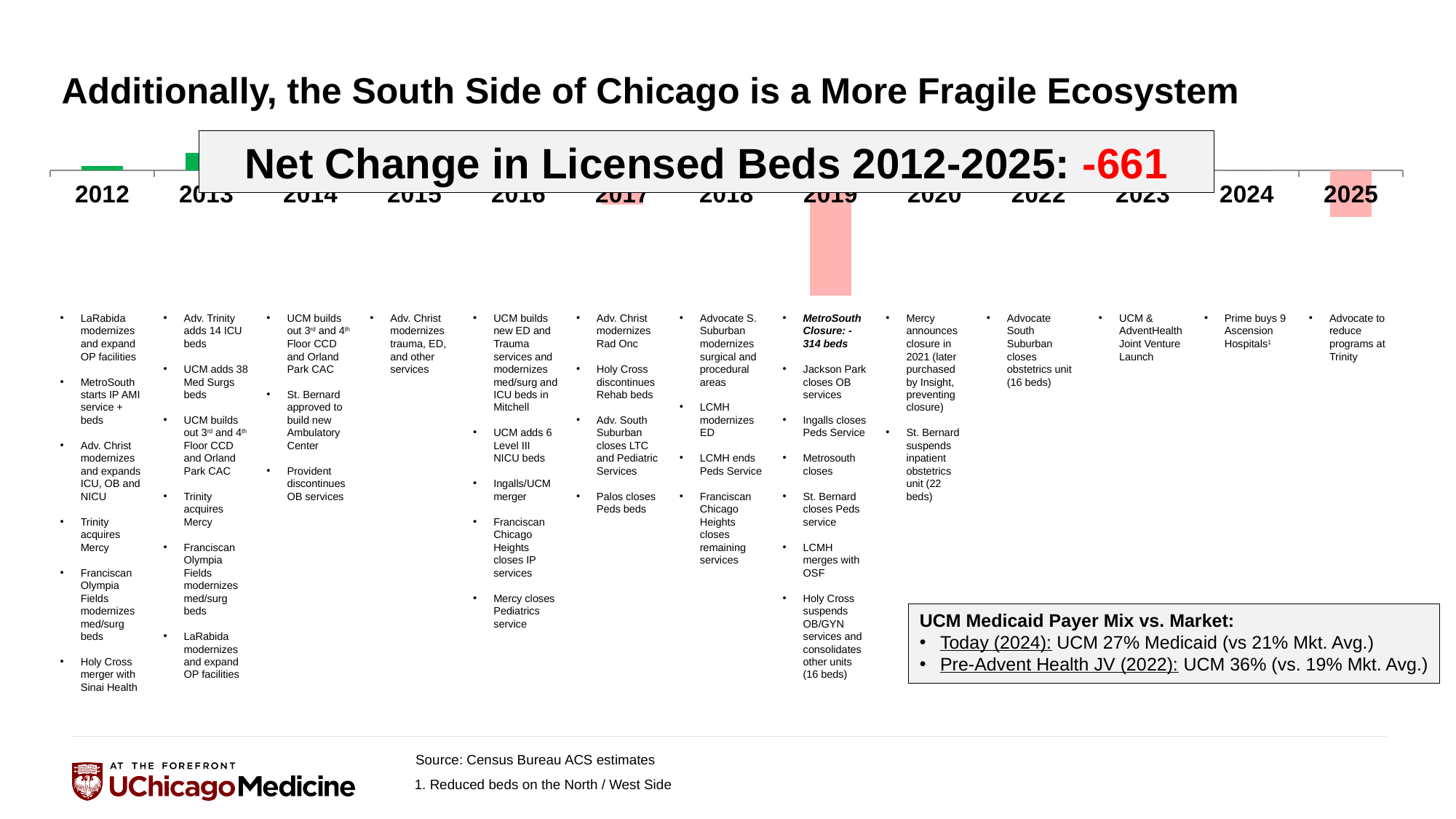
Which year between 2012 and 2025 is not labeled on the timeline chart's x axis? 2021 What colour is the bar for 2019 in the timeline chart? red Is the red bar for 2019 larger or smaller in magnitude than the red bar for 2017? larger Which year has the largest downward (red) bar in the timeline chart? 2019 How many years are labeled along the x axis of the timeline chart? 13 What net change in licensed beds from 2012-2025 is stated in the box over the chart? -661 Is the red bar for 2019 larger or smaller in magnitude than the red bar for 2025? larger What is the last year labeled on the timeline chart? 2025 What kind of chart is shown on the timeline across the top of the slide? bar chart What colour is the bar for 2012 in the timeline chart? green What is the first year labeled on the timeline chart? 2012